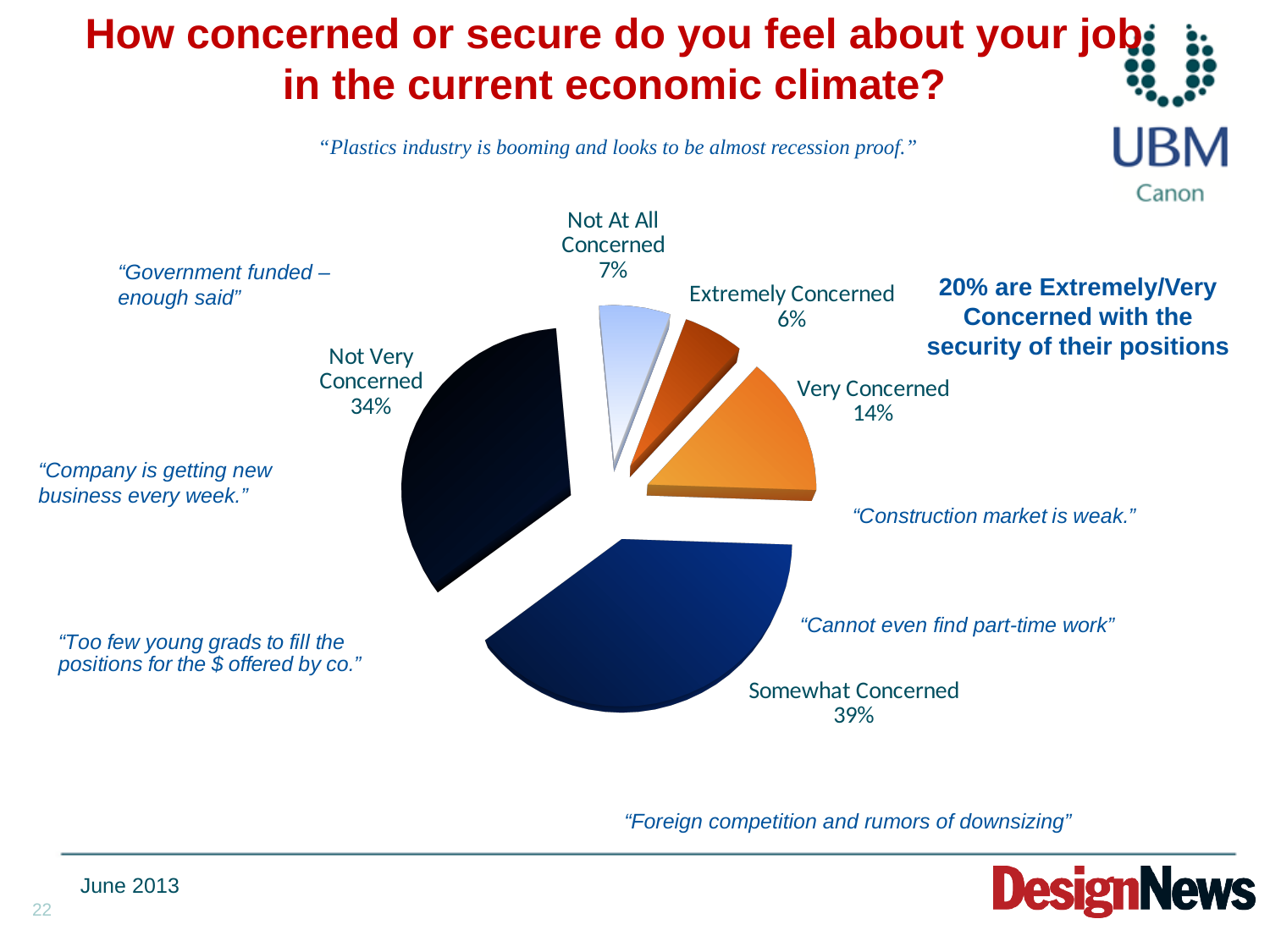
What is the difference in percentage points between Somewhat Concerned and Not Very Concerned? 5 What percentage of respondents are Somewhat Concerned? 39% What percentage of respondents are Extremely Concerned? 6% What is the combined share of Extremely Concerned and Very Concerned? 20% Which category has the largest share of the pie? Somewhat Concerned What percentage of respondents are Not At All Concerned? 7% How many categories are shown in the pie chart? 5 What percentage of respondents are Very Concerned? 14% What percentage of respondents are Not Very Concerned? 34% What type of chart is shown on the slide? Pie chart Which category has the smallest share of the pie? Extremely Concerned Which is larger, the share for Very Concerned or the share for Not At All Concerned? Very Concerned